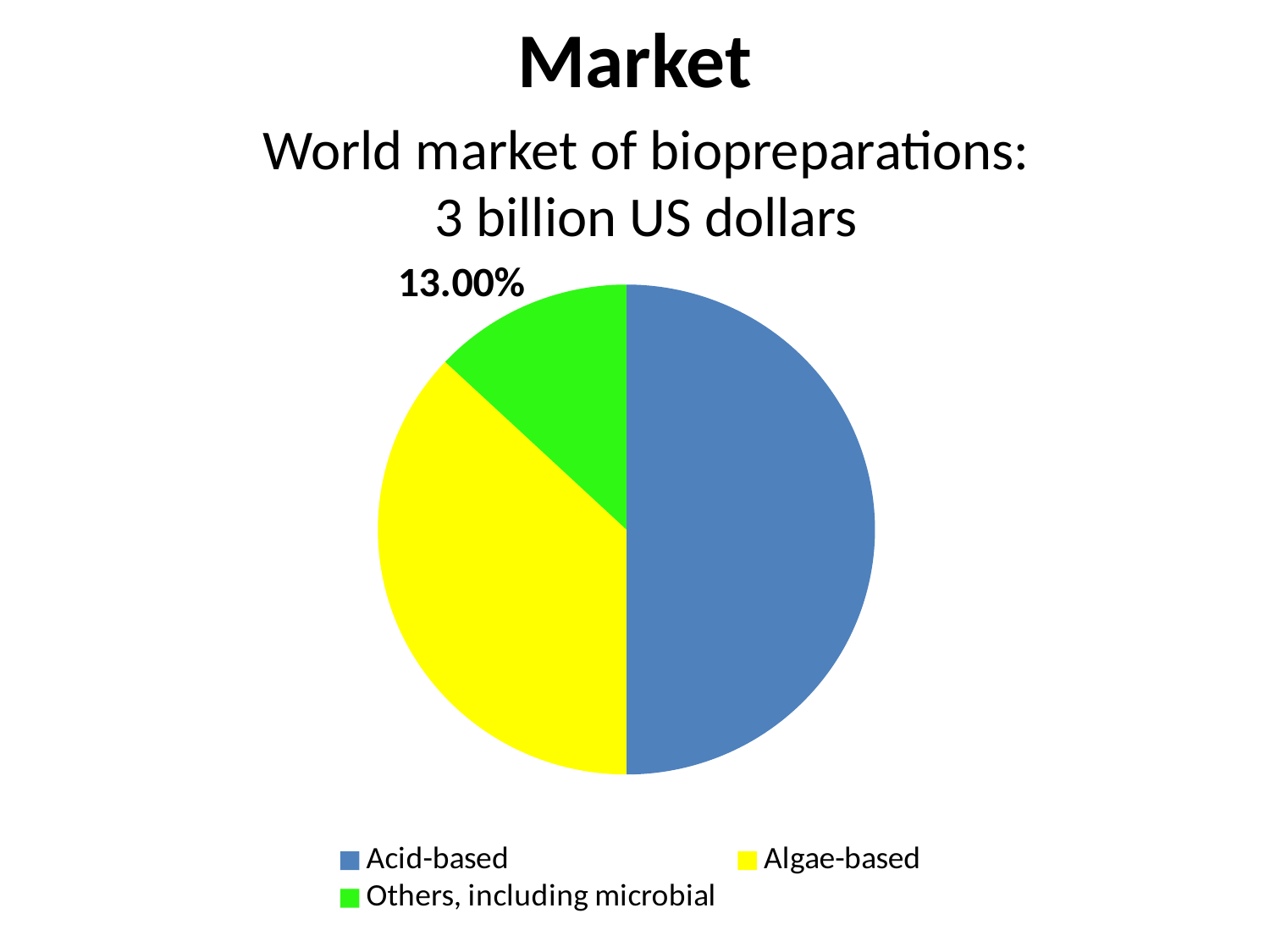
What is the title of the chart? World market of biopreparations: 3 billion US dollars How many slices does the pie chart have? 3 Which category has the smallest slice of the pie? Others, including microbial What share of the pie does the Others, including microbial slice take? 13.00% Which category has the largest slice of the pie? Acid-based What is the value shown for the Others, including microbial slice? 13.00% What kind of chart is shown on the slide? pie chart What colour is the Algae-based slice? yellow Which is larger, the Algae-based slice or the Others, including microbial slice? Algae-based Which is larger, the Acid-based slice or the Algae-based slice? Acid-based How many entries does the legend list? 3